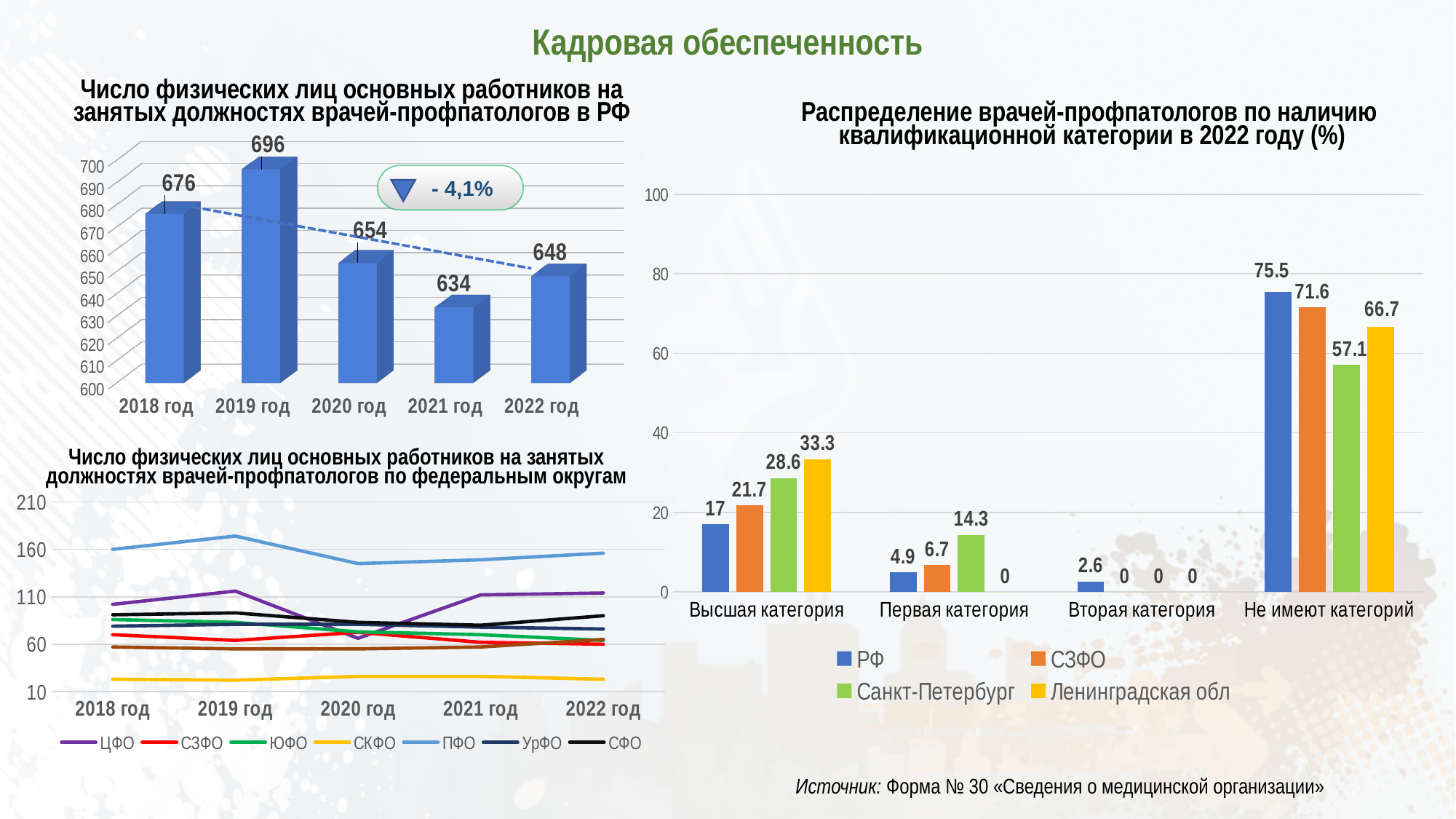
In the top-left chart of physicians in the RF by year, which year has the highest value? 2019 год In the right chart of qualification categories in 2022, what is the difference between РФ and СЗФО in the 'Не имеют категорий' group? 3.9 What kind of chart is the bottom-left chart by federal districts? Line chart In the bottom-left chart by federal districts, is the value for СКФО in 2018 год greater or less than 60? less In the top-left chart of physicians in the RF by year, what is the difference between the 2019 год and 2018 год values? 20 In the top-left chart of physicians in the RF by year, which year has the lowest value? 2021 год In the right chart 'Распределение врачей-профпатологов по наличию квалификационной категории в 2022 году (%)', what is the value for Санкт-Петербург in Первая категория? 14.3 In the top-left chart 'Число физических лиц основных работников на занятых должностях врачей-профпатологов в РФ', what is the value for 2019 год? 696 In the bottom-left chart by federal districts, is the value for ПФО in 2019 год greater or less than 160? greater In the top-left chart of physicians in the RF by year, how many years are shown? 5 In the right chart of qualification categories in 2022, which series has the highest value in the 'Высшая категория' group? Ленинградская обл In the bottom-left chart by federal districts, how many series does the legend list? 7